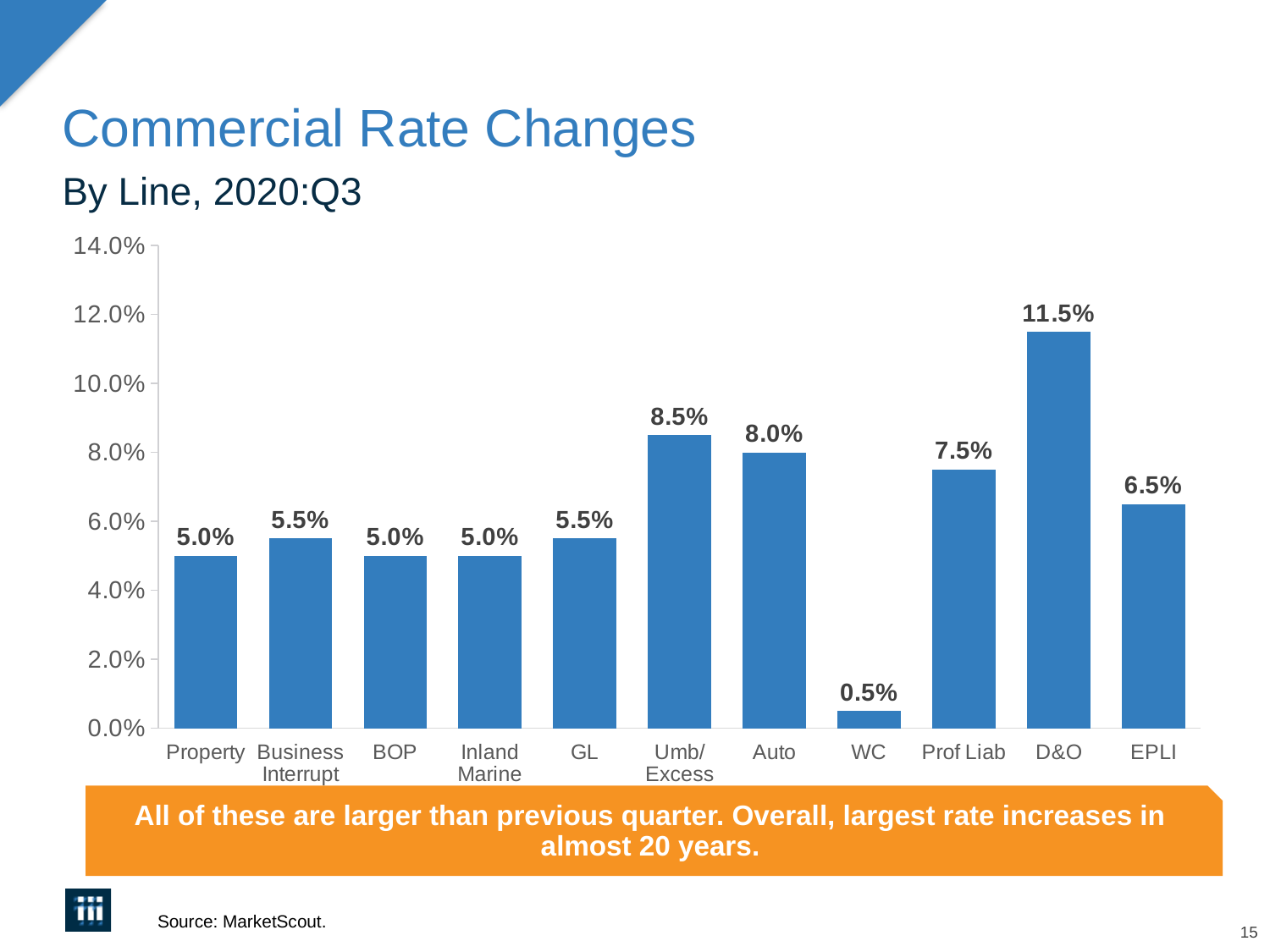
What is the rate change for WC? 0.5% What is the title of the chart? Commercial Rate Changes By Line, 2020:Q3 What is the difference between the rate changes for D&O and EPLI? 5.0% What is the rate change for Umb/Excess? 8.5% Which line has the lowest rate change? WC How many lines are shown on the chart? 11 Which line has the highest rate change? D&O What is the rate change for D&O? 11.5% Which has a larger rate change, Umb/Excess or Auto? Umb/Excess What kind of chart is shown on the slide? Bar chart What is the rate change for Prof Liab? 7.5% What is the difference between the rate changes for Auto and WC? 7.5%